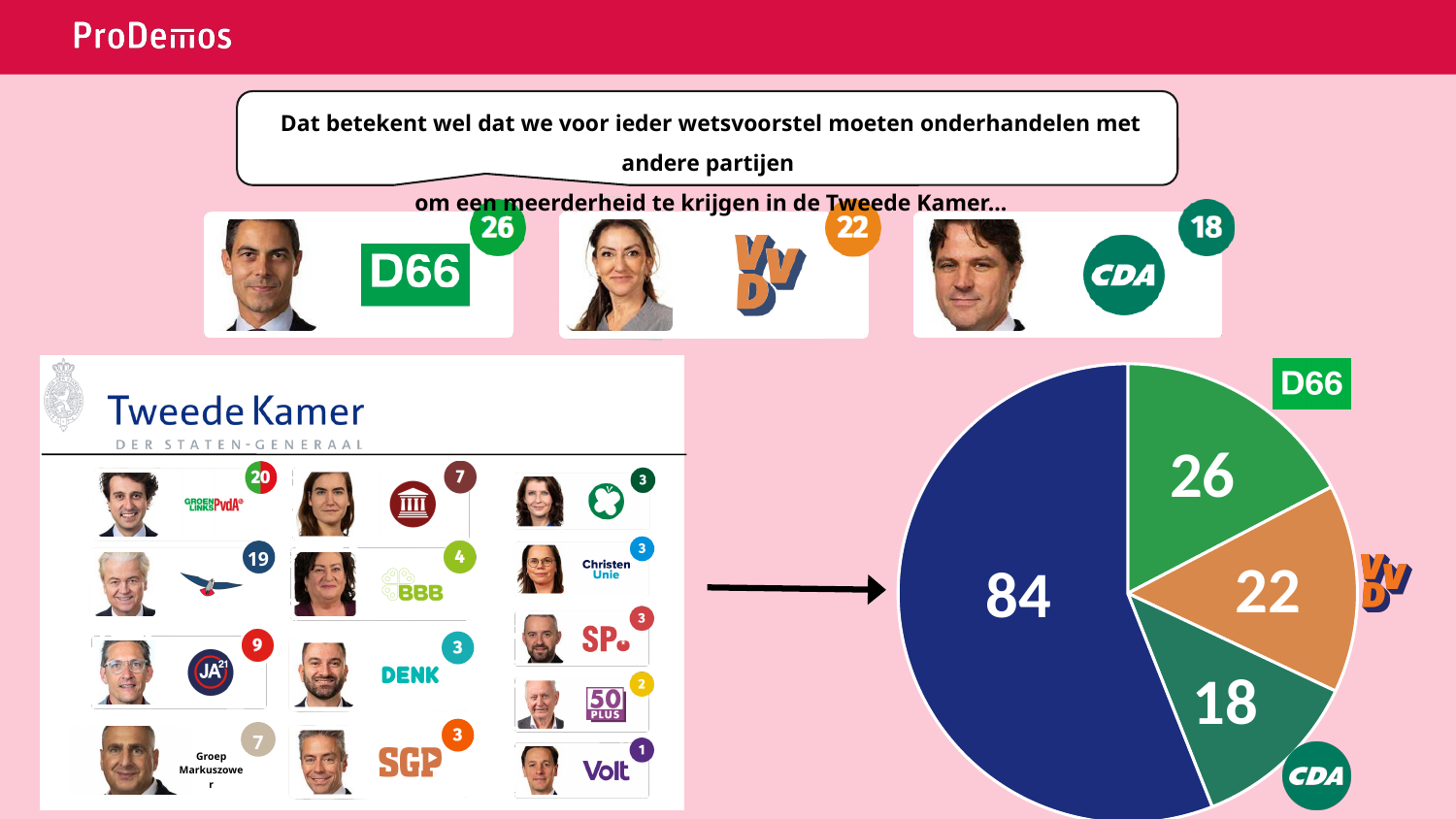
How many slices does the pie chart have? 4 What share of the pie chart does the dark blue slice (84) represent? 56% In the pie chart, what value is shown for the D66 slice? 26 Which slice of the pie chart is the largest? the dark blue slice (84) What is the total of all the values shown in the pie chart? 150 In the pie chart, which is larger: the VVD slice or the CDA slice? VVD Of the labelled parties in the pie chart (D66, VVD, CDA), which has the smallest slice? CDA In the pie chart, what value is shown on the large dark blue slice? 84 In the pie chart, what value is shown for the VVD slice? 22 In the pie chart, what value is shown for the CDA slice? 18 What kind of chart is shown on the right side of the slide? pie chart In the pie chart, what is the difference between the D66 value and the CDA value? 8